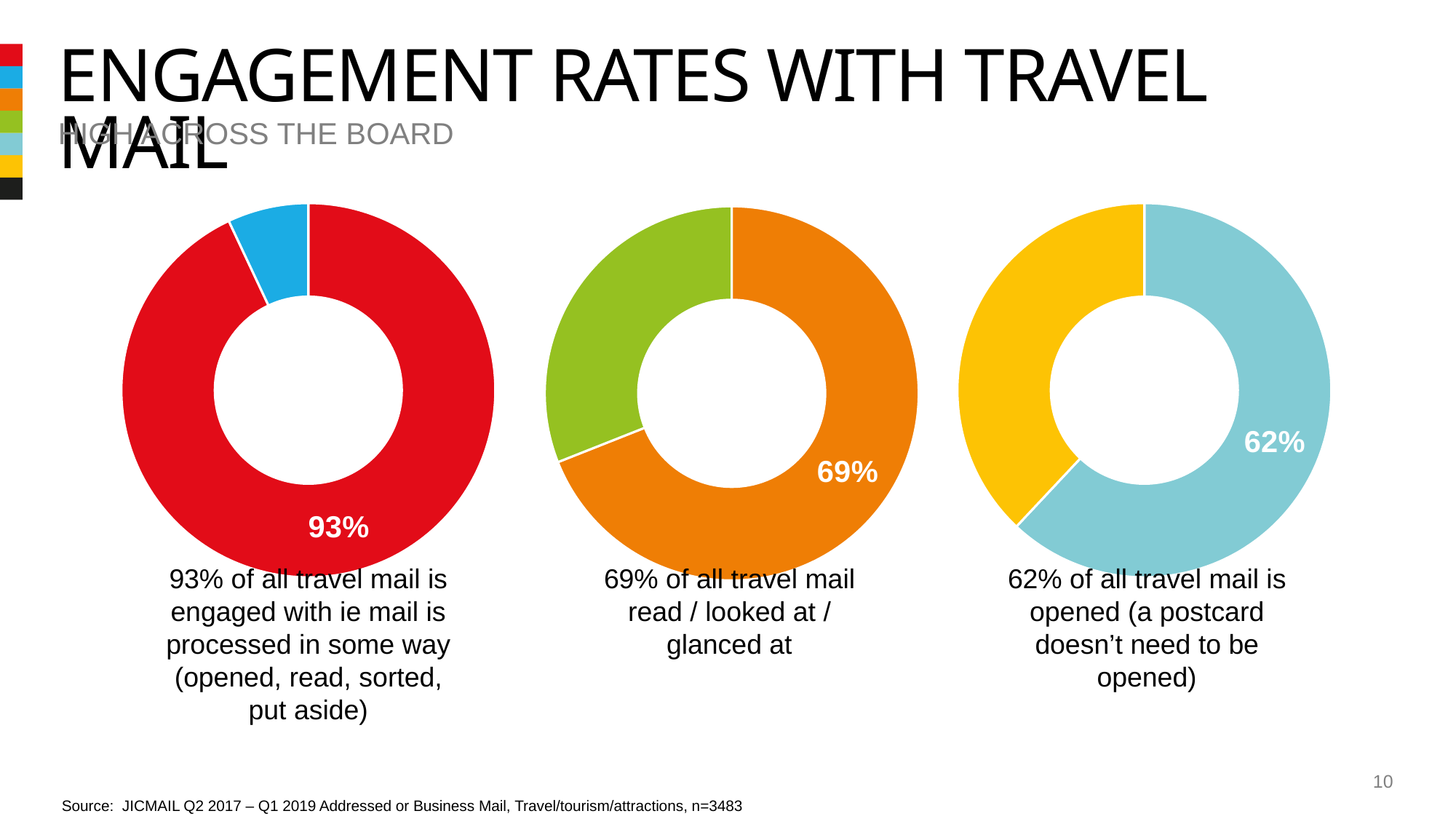
Which of the three donut charts shows the highest labelled percentage? The left chart (93%) What is the difference between the percentage in the left donut chart (93%) and the percentage in the middle donut chart (69%)? 24% Is the labelled percentage in the middle donut chart larger or smaller than the labelled percentage in the right donut chart? Larger What is the difference between the percentage in the middle donut chart (69%) and the percentage in the right donut chart (62%)? 7% In the left donut chart, what percentage is shown on the large red slice? 93% Which of the three donut charts shows the lowest labelled percentage? The right chart (62%) In the middle donut chart, what percentage is shown on the orange slice? 69% What kind of chart is used to show the engagement rates on this slide? Donut (pie) chart How many donut charts are on the slide? 3 What colour is the largest slice in the left donut chart? Red In the right donut chart, what percentage is shown on the light blue slice? 62% How many slices does the left donut chart have? 2